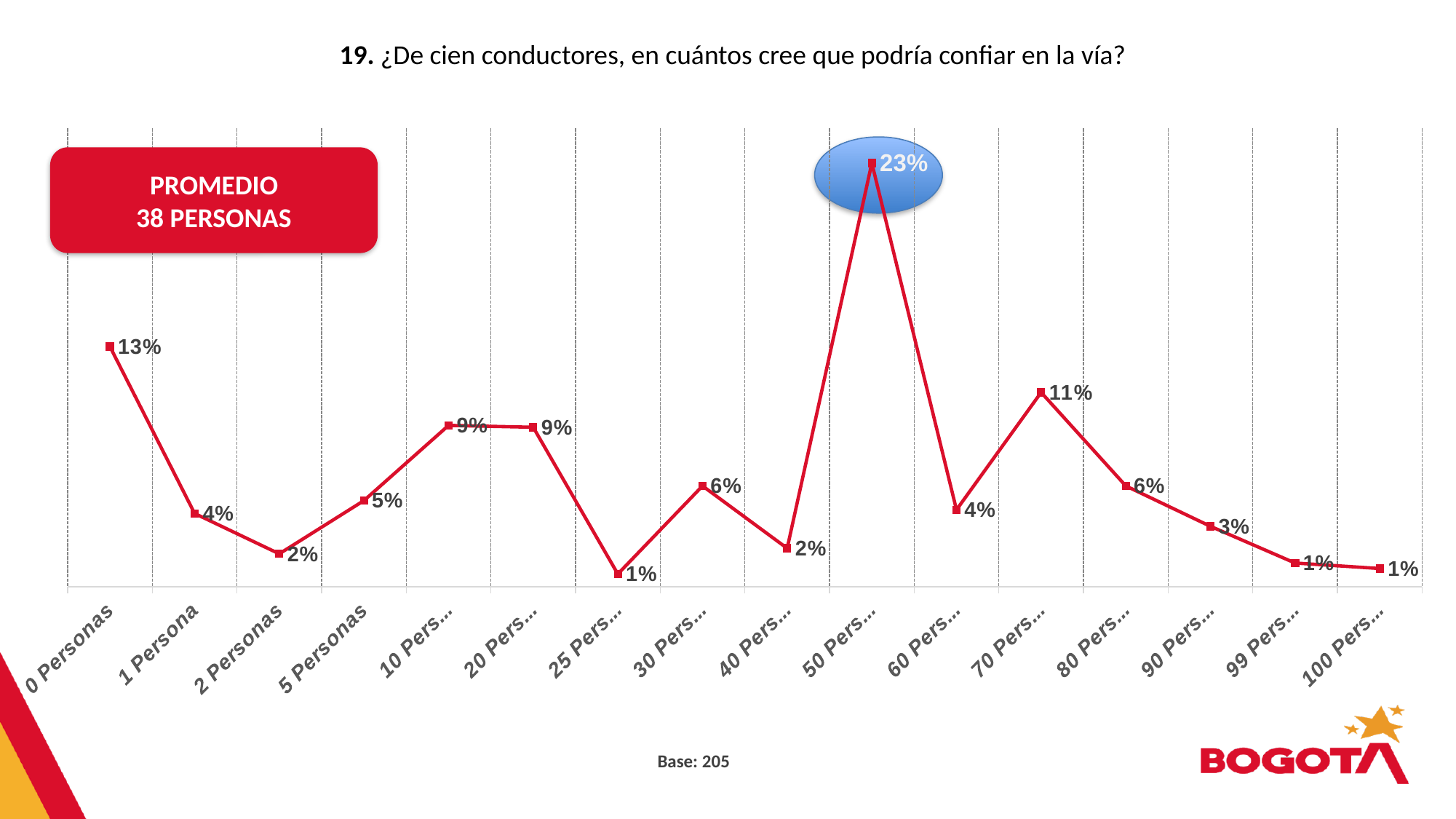
What is the difference between the values for 70 Pers... and 60 Pers...? 7% How many categories are shown on the x axis? 16 What is the difference between the values for 50 Pers... and 0 Personas? 10% Which is larger, the value for 1 Persona or the value for 2 Personas? 1 Persona What kind of chart is shown on the slide? Line chart Which is larger, the value for 80 Pers... or the value for 90 Pers...? 80 Pers... What average (promedio) is stated in the red box on the slide? 38 personas What value is shown for 70 Pers...? 11% What value is shown for 5 Personas? 5% What value is shown for 0 Personas? 13% What value is shown for 30 Pers...? 6% Which category has the highest value? 50 Pers...